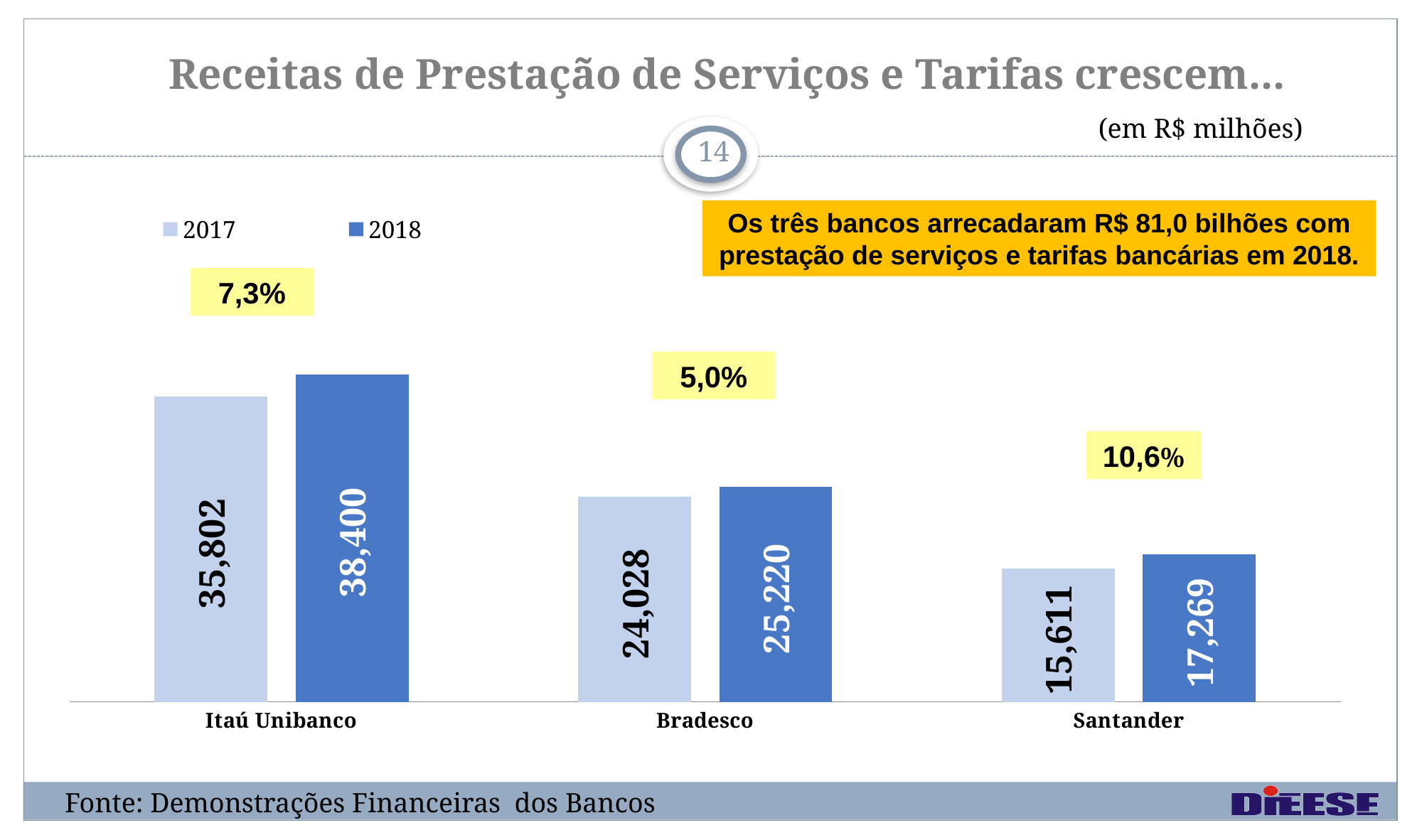
What is the 2018 value for Itaú Unibanco? 38,400 What is the 2017 value for Bradesco? 24,028 How many series does the legend list? 2 Which bank has the highest 2018 value? Itaú Unibanco What is the difference between the 2018 and 2017 values for Santander? 1,658 Which bank has the lowest 2017 value? Santander What is the 2017 value for Santander? 15,611 How many banks are shown on the x axis? 3 Which is larger: the 2017 value for Bradesco or the 2018 value for Santander? 2017 value for Bradesco What is the 2018 value for Santander? 17,269 What kind of chart is shown on the slide? Bar chart What is the difference between the 2018 and 2017 values for Itaú Unibanco? 2,598